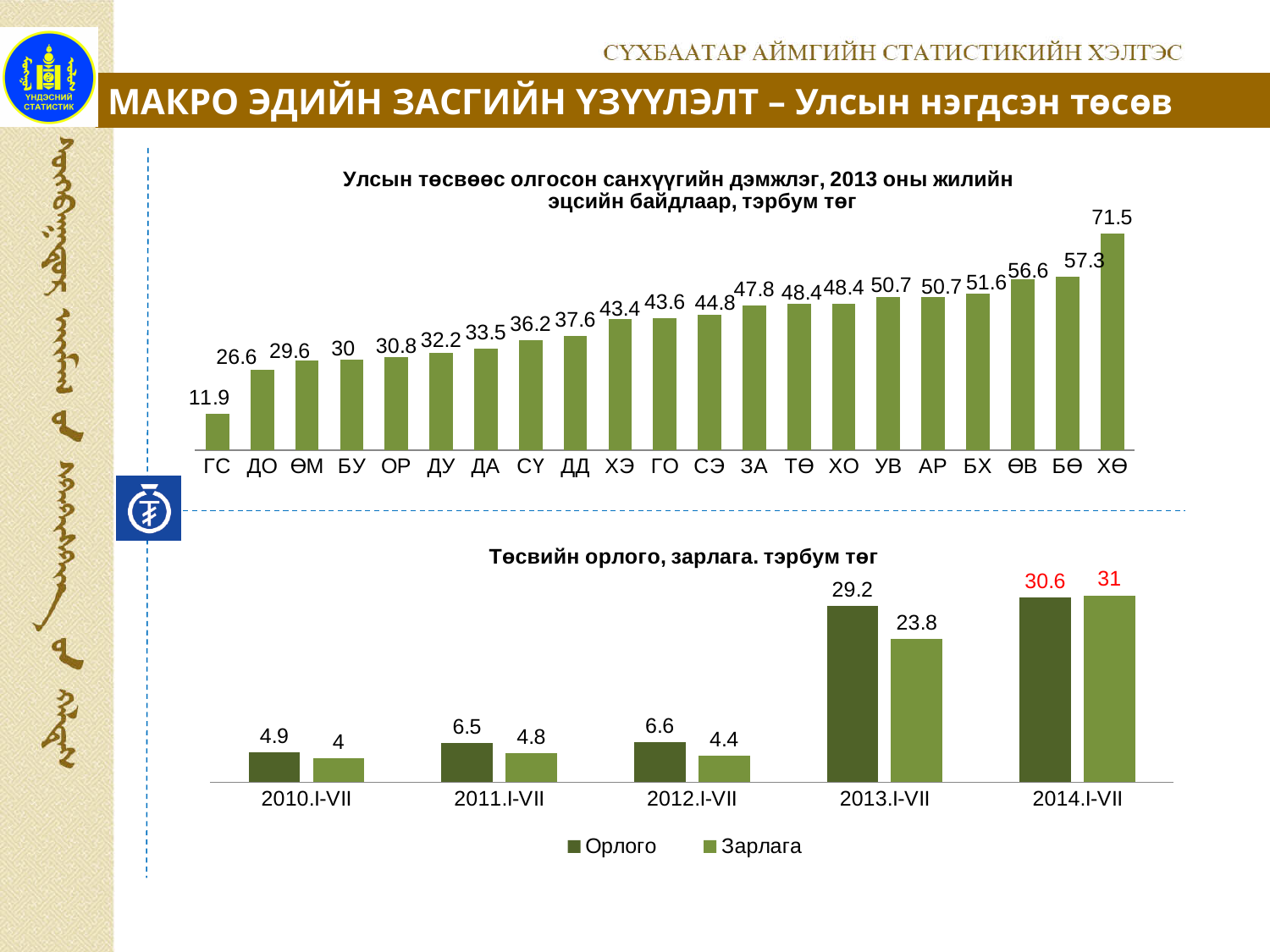
In the top chart (Улсын төсвөөс олгосон санхүүгийн дэмжлэг), how many categories are shown? 21 In the bottom chart (Төсвийн орлого, зарлага), which is larger for 2014.I-VII, Орлого or Зарлага? Зарлага In the top chart (Улсын төсвөөс олгосон санхүүгийн дэмжлэг), what is the value for ХЭ? 43.4 In the bottom chart (Төсвийн орлого, зарлага), how many series does the legend list? 2 In the bottom chart (Төсвийн орлого, зарлага), what is the Орлого value for 2013.I-VII? 29.2 In the top chart (Улсын төсвөөс олгосон санхүүгийн дэмжлэг), which category has the lowest value? ГС What type of chart is the bottom chart (Төсвийн орлого, зарлага)? bar chart In the top chart (Улсын төсвөөс олгосон санхүүгийн дэмжлэг), do the values rise or fall from left to right? rise In the bottom chart (Төсвийн орлого, зарлага), what is the difference between Орлого and Зарлага for 2013.I-VII? 5.4 In the top chart (Улсын төсвөөс олгосон санхүүгийн дэмжлэг), what is the difference between the values for ХӨ and БӨ? 14.2 In the top chart (Улсын төсвөөс олгосон санхүүгийн дэмжлэг), which category has the highest value? ХӨ In the bottom chart (Төсвийн орлого, зарлага), what is the Зарлага value for 2011.I-VII? 4.8